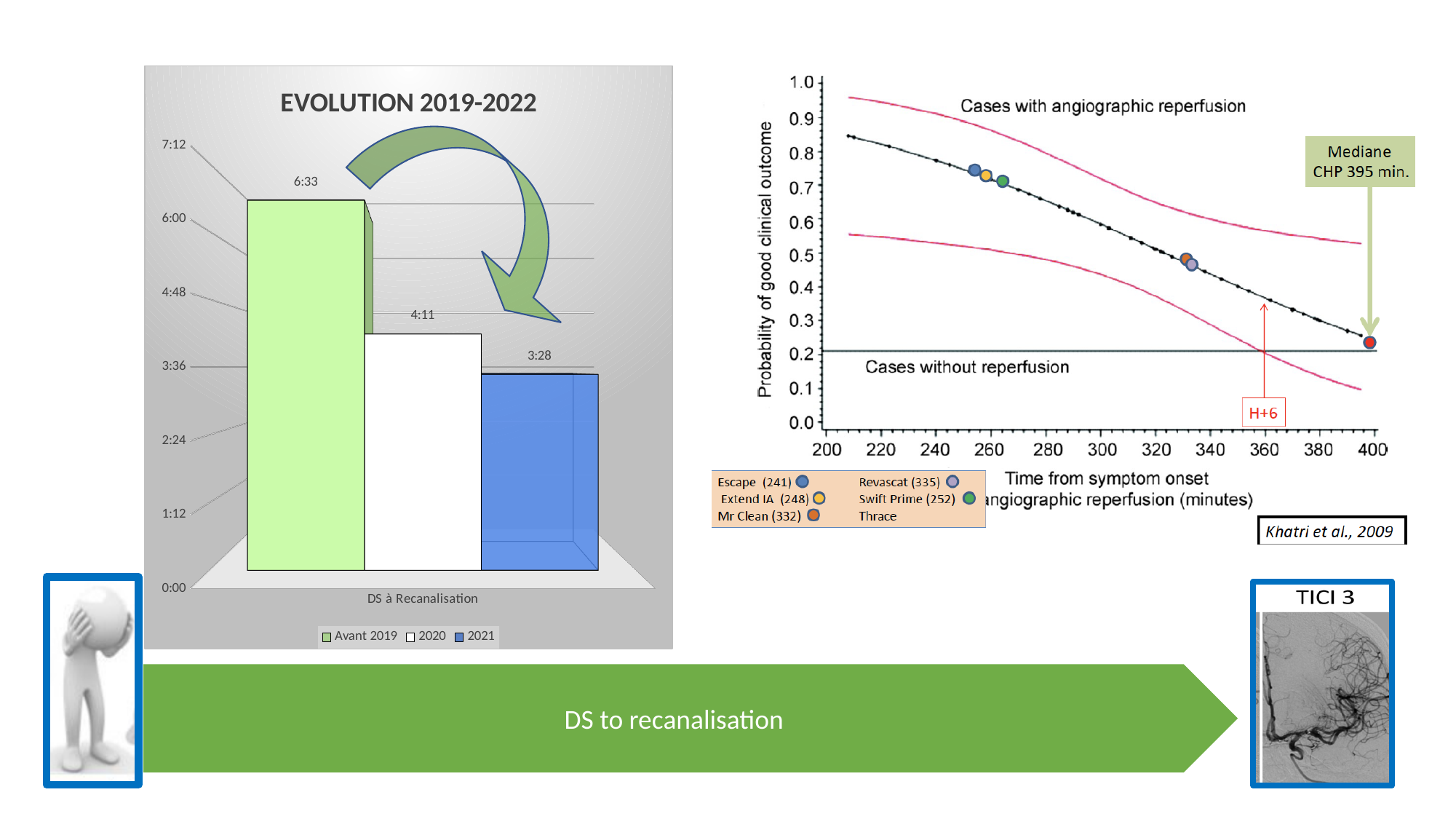
On the EVOLUTION 2019-2022 chart, how many series does the legend list? 3 On the EVOLUTION 2019-2022 chart, do the values rise or fall from Avant 2019 to 2021? Fall On the Khatri et al. 2009 chart on the right, is the probability of good clinical outcome at the Mediane CHP point (about 395 minutes) greater or less than 0.3? less On the EVOLUTION 2019-2022 chart, which series has the highest value? Avant 2019 On the EVOLUTION 2019-2022 chart, which is larger, the 2020 value or the 2021 value? 2020 On the EVOLUTION 2019-2022 chart, what is the value for 2021? 3:28 On the EVOLUTION 2019-2022 chart, what is the difference between the Avant 2019 value and the 2021 value? 3:05 On the Khatri et al. 2009 chart on the right, does the probability of good clinical outcome rise or fall as time from symptom onset increases? Fall What kind of chart is the EVOLUTION 2019-2022 chart? Bar chart On the EVOLUTION 2019-2022 chart, what is the value for 2020? 4:11 On the EVOLUTION 2019-2022 chart, which series has the lowest value? 2021 On the EVOLUTION 2019-2022 chart, what is the value for Avant 2019? 6:33